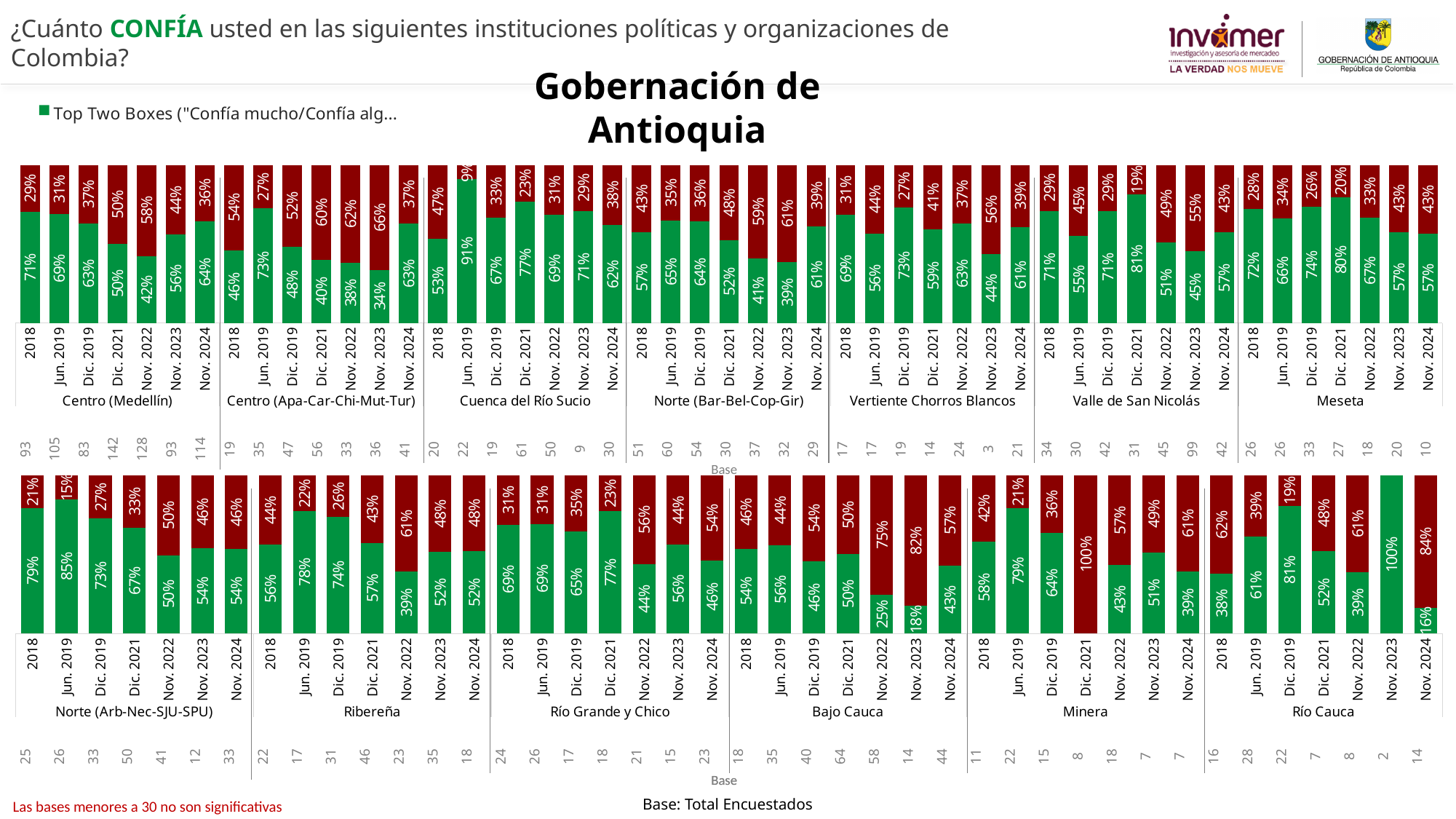
In the top chart, what is the green value for Cuenca del Río Sucio in Jun. 2019? 91% In the top chart, which is larger for Meseta: the green value in Dic. 2021 or in Nov. 2023? Dic. 2021 In the top chart, which period has the highest green value for Valle de San Nicolás? Dic. 2021 What kind of chart is used on this slide? Stacked bar chart In the bottom chart, what is the difference between the green values for Norte (Arb-Nec-SJU-SPU) in Jun. 2019 and Nov. 2022? 35 percentage points In the bottom chart, what is the total of the stacked bar for Minera in Nov. 2022? 100% In the top chart, which period has the lowest green value for Centro (Apa-Car-Chi-Mut-Tur)? Nov. 2023 In the bottom chart, what is the red value for Río Cauca in Nov. 2024? 84% In the bottom chart, what is the green value for Bajo Cauca in Nov. 2023? 18% In the top chart, what is the Top Two Boxes (green) value for Centro (Medellín) in 2018? 71% How many regions are shown in the bottom chart? 6 What is the base (number of respondents) for Centro (Medellín) in Dic. 2021 in the top chart? 142